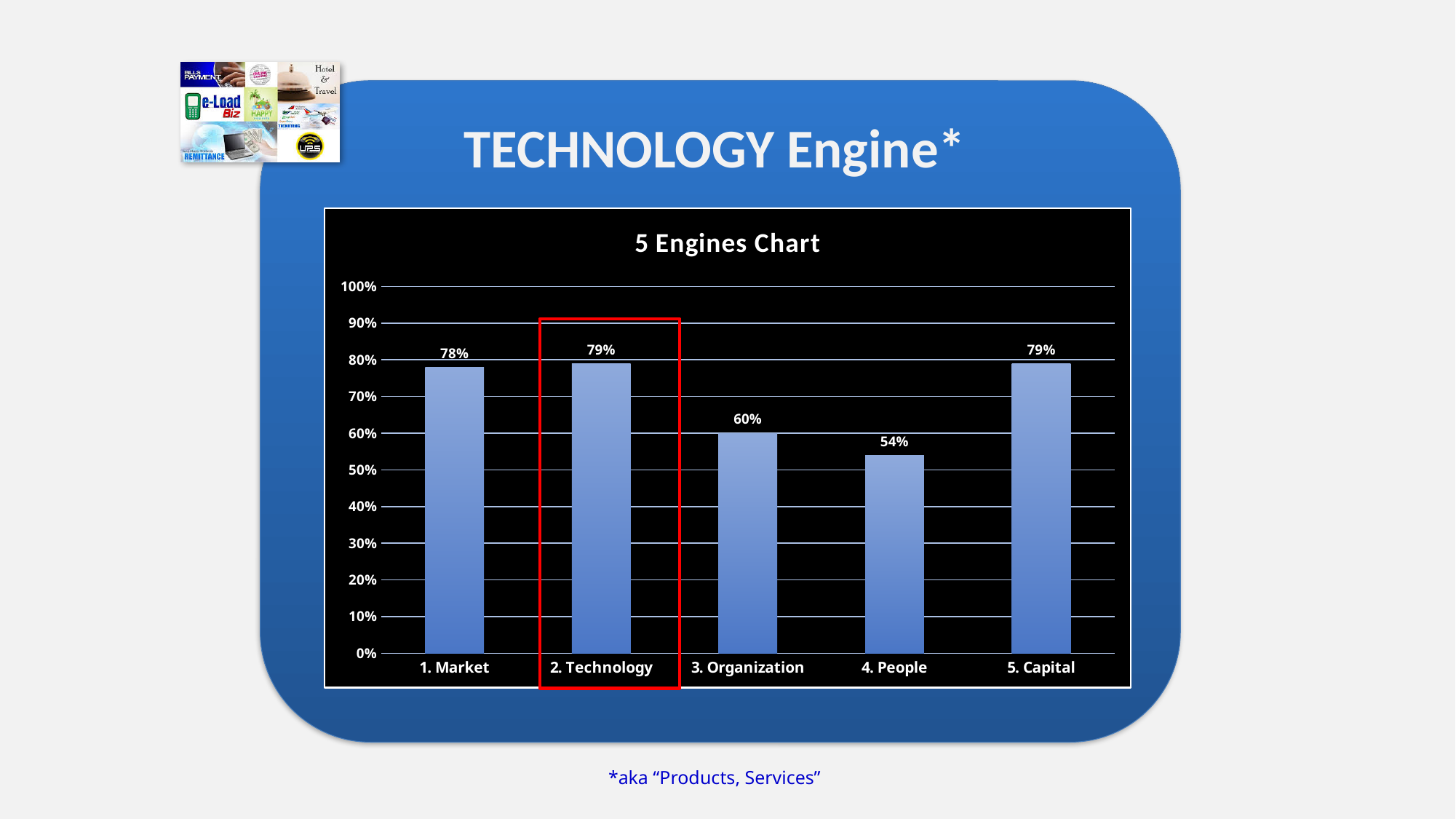
Which is larger, the value for 3. Organization or the value for 4. People? 3. Organization What is the difference between the values for 2. Technology and 4. People? 25% Which category is highlighted with a red outline in the 5 Engines Chart? 2. Technology How many categories are shown in the 5 Engines Chart? 5 What is the value for 3. Organization in the 5 Engines Chart? 60% What is the value for 4. People in the 5 Engines Chart? 54% What is the value for 1. Market in the 5 Engines Chart? 78% What kind of chart is the 5 Engines Chart? bar chart What is the difference between the values for 1. Market and 3. Organization? 18% Which category has the lowest value in the 5 Engines Chart? 4. People Is the value for 5. Capital greater or less than 70%? greater What is the value for 2. Technology in the 5 Engines Chart? 79%